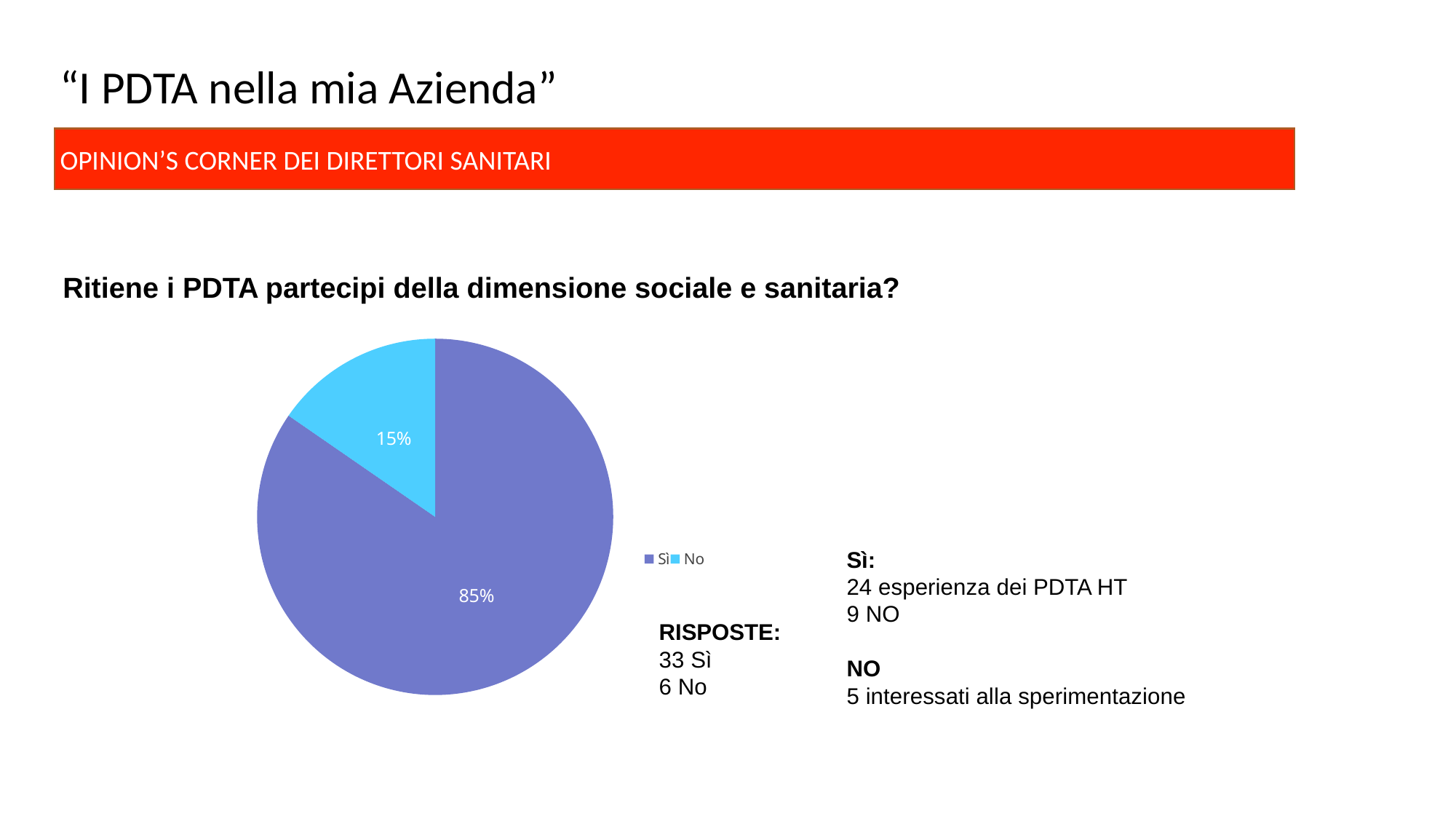
What question does the pie chart answer, according to the heading above it? Ritiene i PDTA partecipi della dimensione sociale e sanitaria? What is the difference in percentage points between the "Sì" slice and the "No" slice? 70 What kind of chart is shown on the slide? pie chart What share of the pie does the "No" slice represent? 15% Which slice of the pie is the largest? Sì What percentage of the pie is labelled for "No"? 15% Which slice is larger, "Sì" or "No"? Sì How many slices does the pie chart have? 2 What colour is the "No" slice in the pie chart? light blue How many entries does the legend list? 2 Which slice of the pie is the smallest? No What percentage of the pie is labelled for "Sì"? 85%